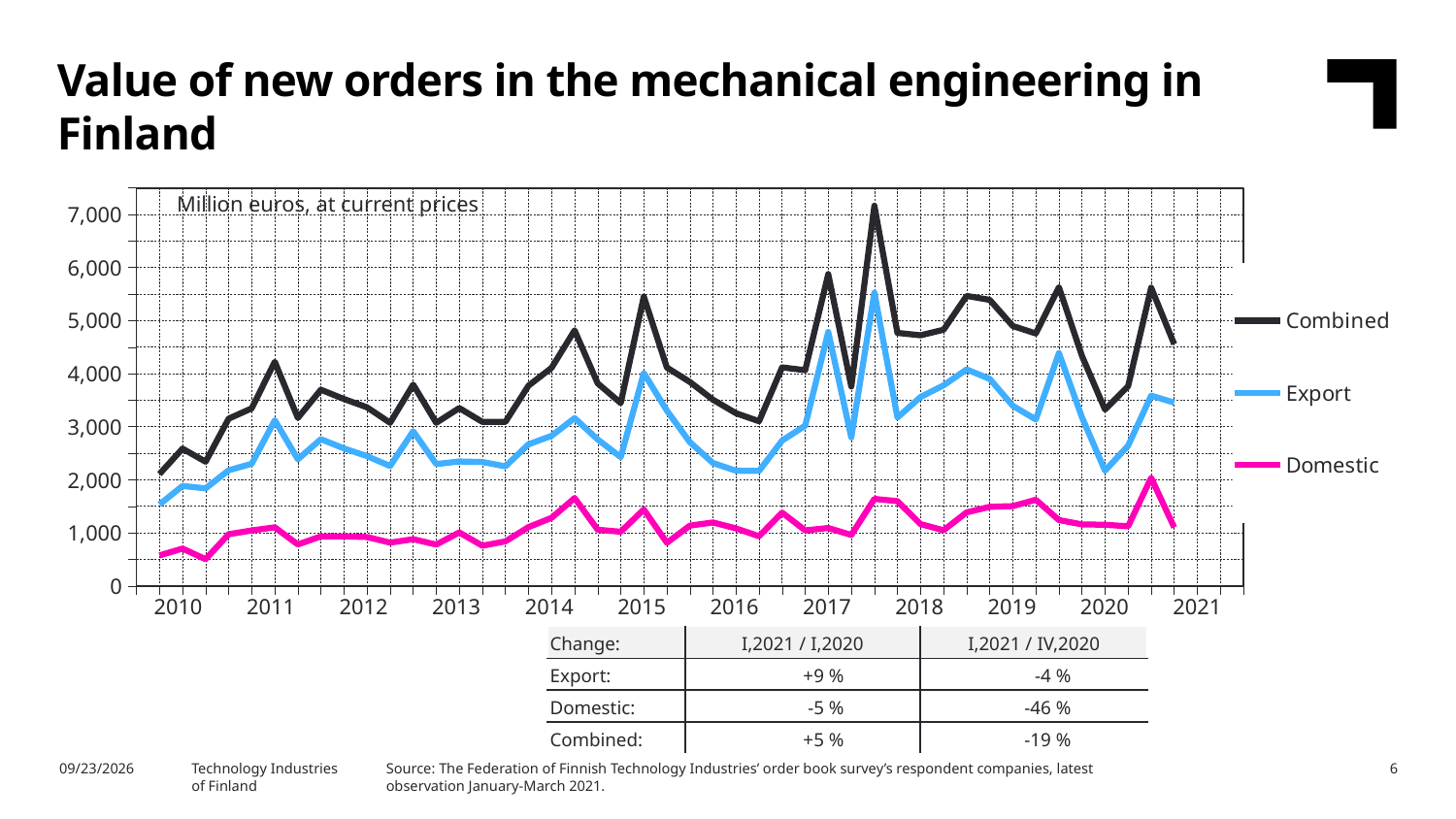
Which series has the lowest values throughout the chart? Domestic Is the value of the Combined series at the start of 2010 greater or less than 3,000? less Which series has the highest values throughout the chart? Combined Which is larger in 2017: the peak of the Export series or the peak of the Domestic series? Export How many series does the legend list? 3 Is the peak value of the Export series in 2017 greater or less than 5,000? greater What unit is stated at the top of the chart? Million euros, at current prices What colour is the Export line in the legend? blue What kind of chart is shown on the slide? line chart According to the change table, what is the Domestic change for I,2021 / IV,2020? -46 % Is the peak value of the Combined series in 2017 greater or less than 6,000? greater